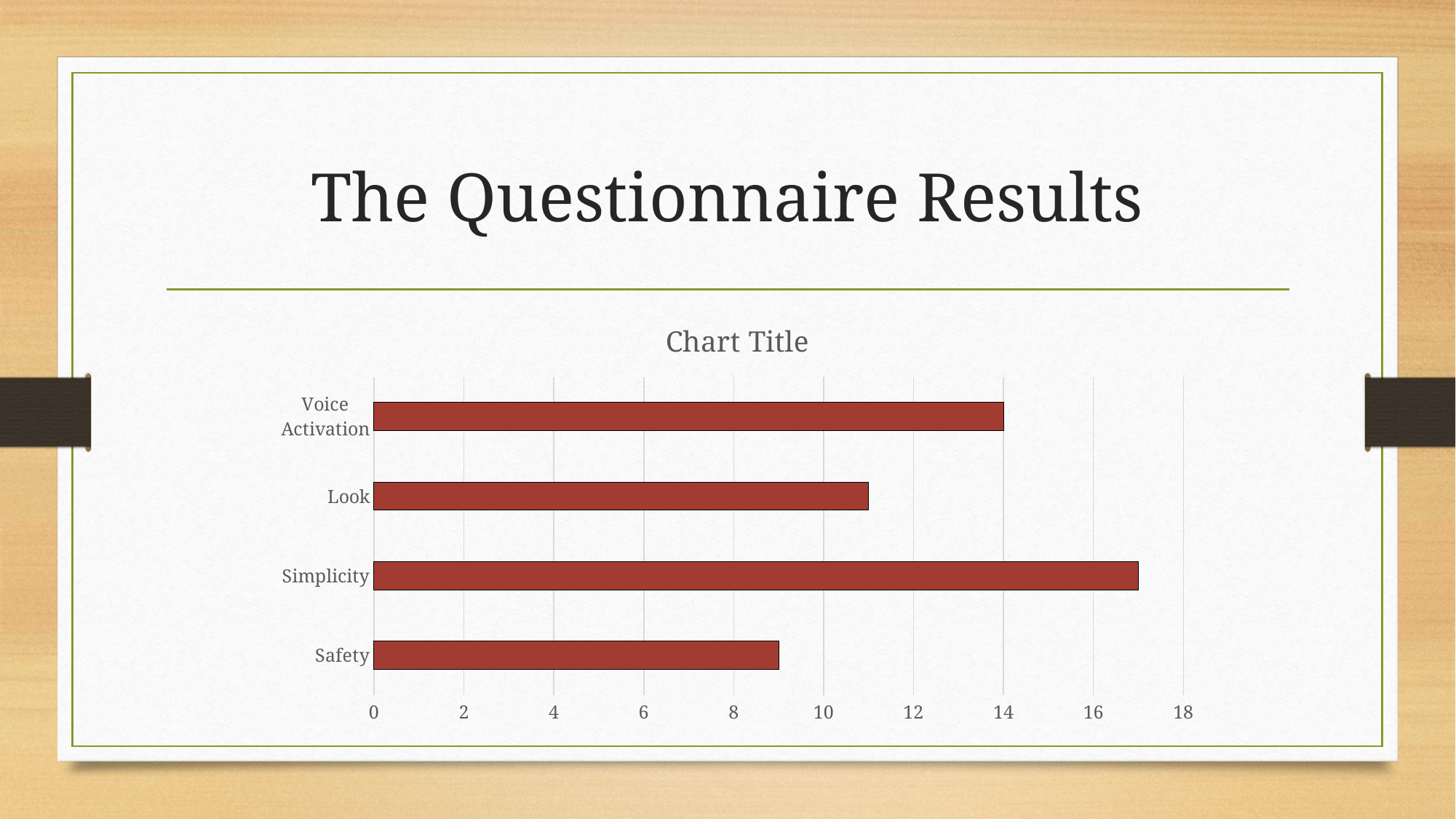
Which is larger, the value for Look or the value for Voice Activation? Voice Activation Is the value for Look greater or less than 12? less What kind of chart is shown on the slide? bar chart Is the value for Simplicity greater or less than 16? greater Which is larger, the value for Safety or the value for Simplicity? Simplicity How many categories are plotted in the chart? 4 Is the value for Safety greater or less than 10? less What is the value for Voice Activation? 14 Which category has the highest value in the chart? Simplicity What is the title shown above the chart? Chart Title Which category has the lowest value in the chart? Safety